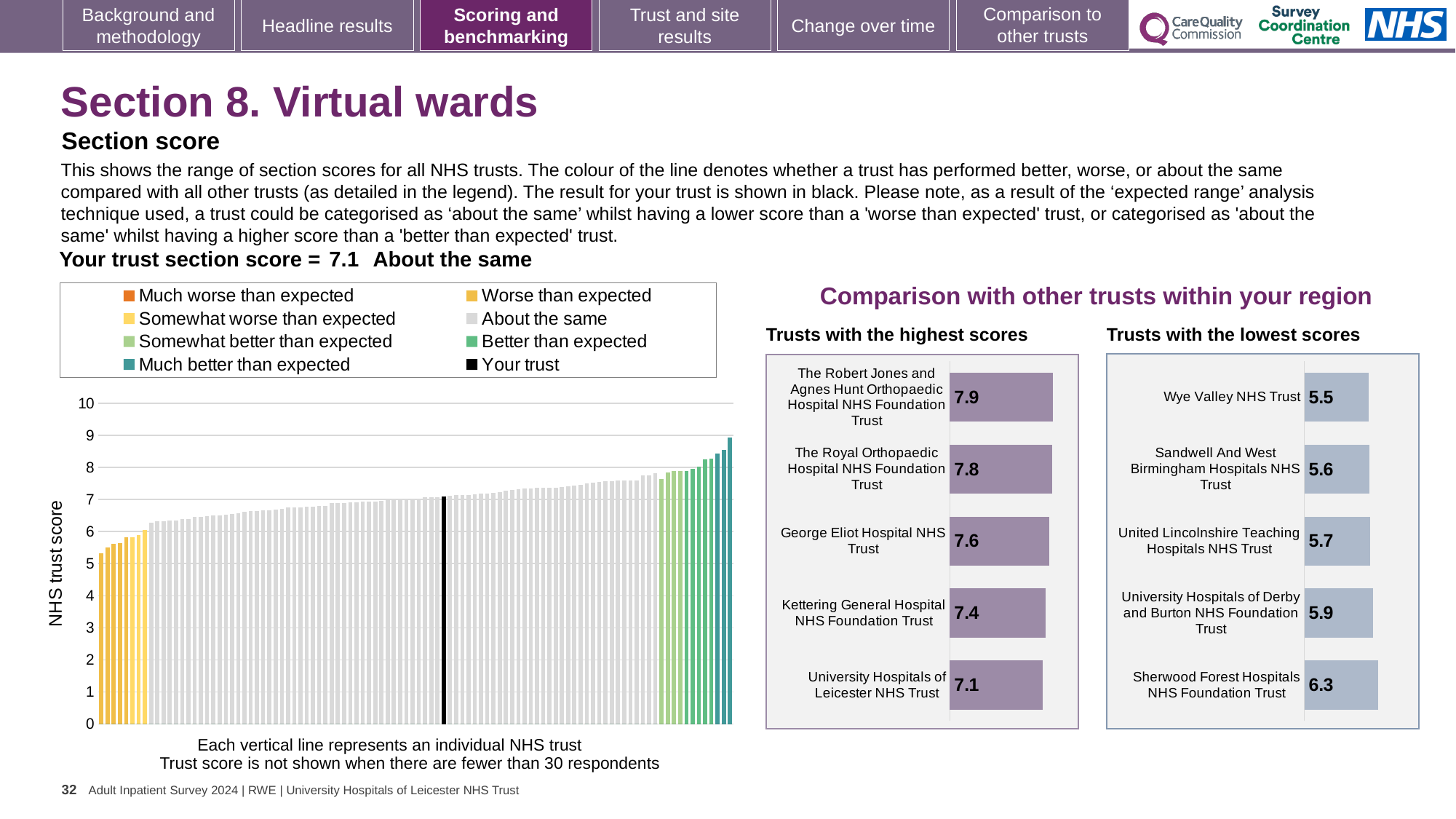
In the 'Trusts with the lowest scores' chart, what is the difference between the scores of Sherwood Forest Hospitals NHS Foundation Trust and Wye Valley NHS Trust? 0.8 How many entries does the legend of the main chart on the left list? 8 In the 'Trusts with the highest scores' chart, what is the score for George Eliot Hospital NHS Trust? 7.6 In the 'Trusts with the lowest scores' chart, what is the score for Sherwood Forest Hospitals NHS Foundation Trust? 6.3 In the main chart of NHS trust scores on the left, do the values rise or fall from left to right along the x axis? rise In the 'Trusts with the lowest scores' chart, which trust has the lowest score? Wye Valley NHS Trust In the main chart of NHS trust scores on the left, is the value of the tallest bar greater or less than 8? greater In the 'Trusts with the highest scores' chart, what is the difference between the scores of The Robert Jones and Agnes Hunt Orthopaedic Hospital NHS Foundation Trust and University Hospitals of Leicester NHS Trust? 0.8 In the 'Trusts with the highest scores' chart, how many trusts are shown? 5 In the 'Trusts with the lowest scores' chart, which has the larger score: United Lincolnshire Teaching Hospitals NHS Trust or University Hospitals of Derby and Burton NHS Foundation Trust? University Hospitals of Derby and Burton NHS Foundation Trust In the main chart of NHS trust scores on the left, what is the section score for your trust? 7.1 In the 'Trusts with the highest scores' chart, which trust has the highest score? The Robert Jones and Agnes Hunt Orthopaedic Hospital NHS Foundation Trust